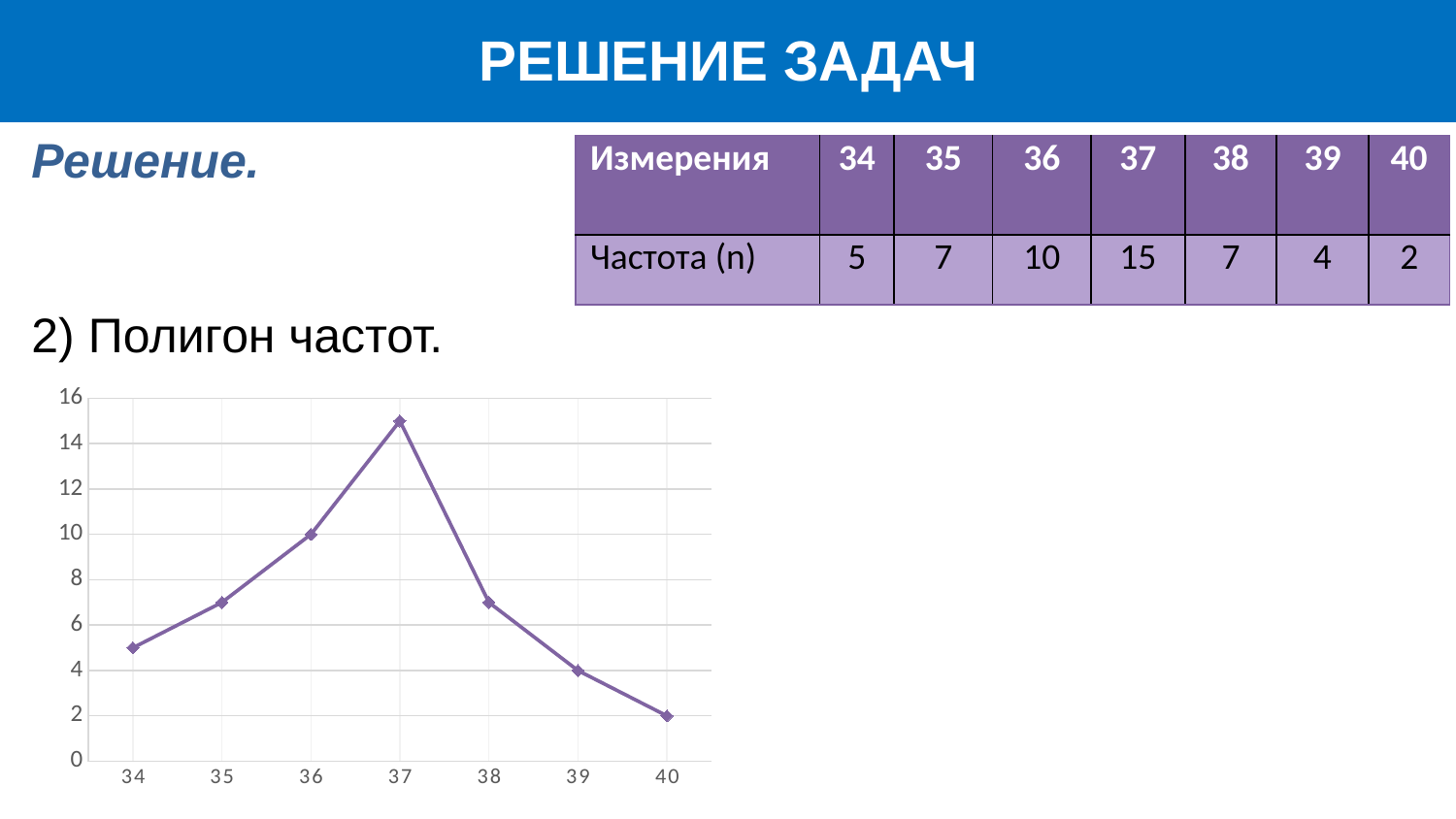
Is the value plotted at 34 on the line chart greater or less than 6? less Do the values on the line chart rise or fall from 37 to 40? fall How many points are plotted on the line chart? 7 Which x-axis value has the lowest point on the line chart? 40 Is the value plotted at 37 on the line chart greater or less than 14? greater Which x-axis value has the highest point on the line chart? 37 Which is larger on the line chart, the value at 36 or the value at 38? 36 What is the value plotted at 37 on the line chart? 15 What is the value plotted at 36 on the line chart? 10 What kind of chart is shown on the slide? line chart What is the value plotted at 40 on the line chart? 2 What is the difference between the values plotted at 37 and 36 on the line chart? 5